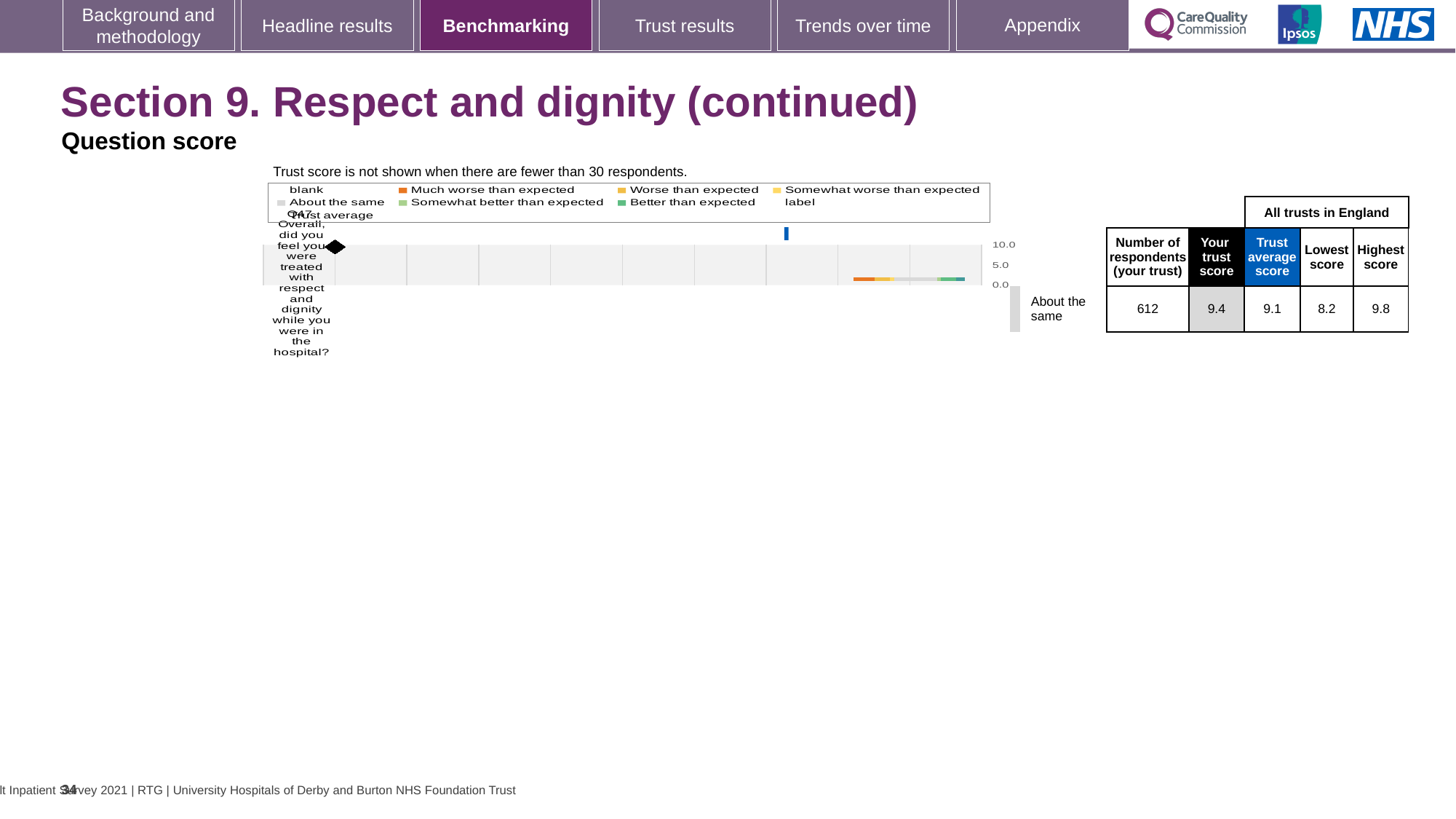
According to the table beside the chart, what is the lowest score among all trusts in England? 8.2 What is the difference between the highest score and the lowest score among all trusts in England? 1.6 Below how many respondents is the trust score not shown, according to the note above the chart? 30 According to the table beside the chart, what is the number of respondents for your trust? 612 According to the table beside the chart, what is the trust average score for all trusts in England? 9.1 Which is larger: your trust score or the trust average score? Your trust score Which question number is labelled on the chart's category axis? Q47 According to the table beside the chart, what is your trust score for Q47? 9.4 According to the table beside the chart, what is the highest score among all trusts in England? 9.8 What kind of chart is shown on the slide? bar chart What is the highest tick value shown on the chart's value axis? 10.0 What benchmark category is your trust's score for Q47 placed in, as labelled next to the chart? About the same